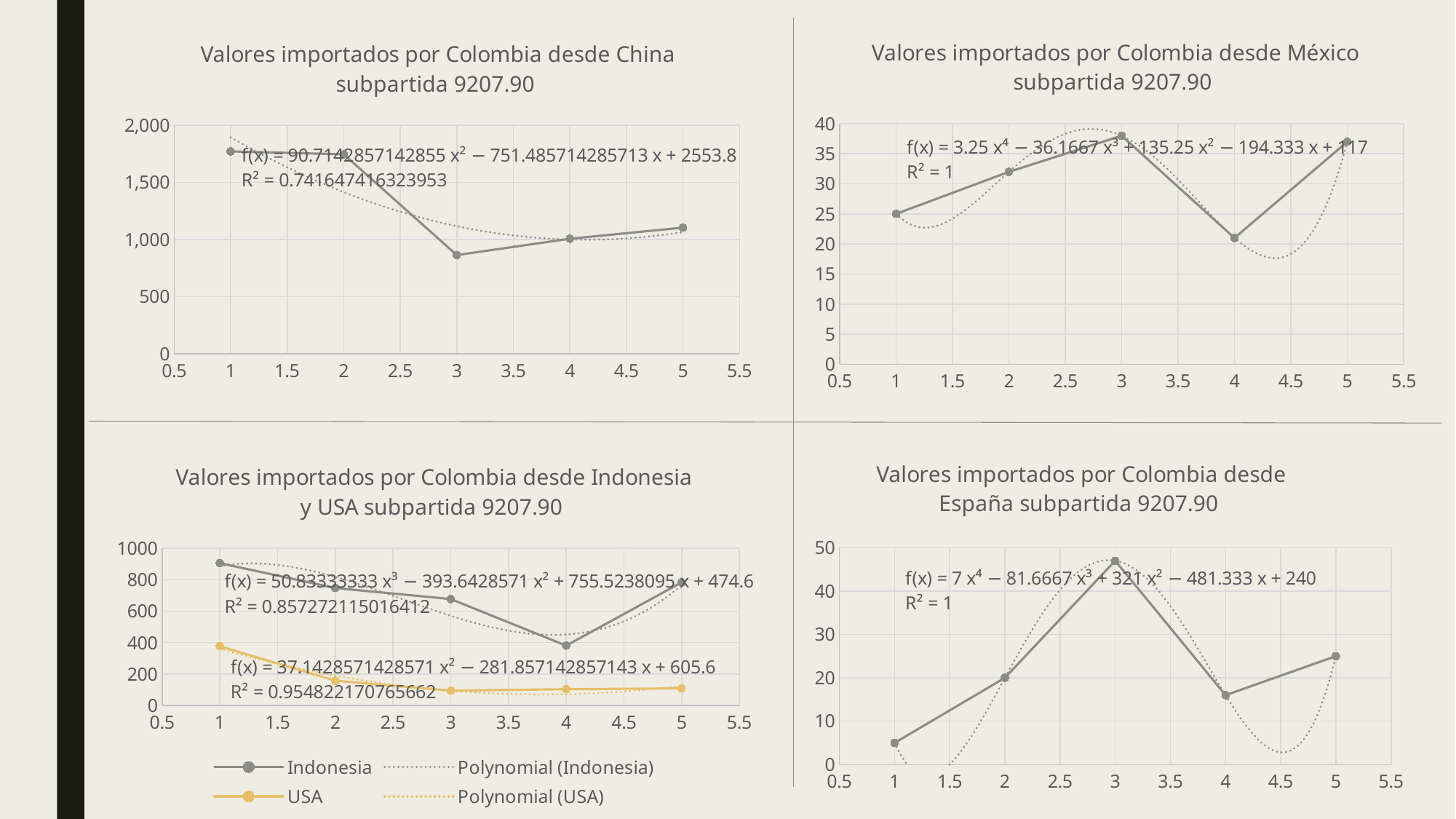
On the chart 'Valores importados por Colombia desde China subpartida 9207.90', what kind of chart is it? line chart On the chart 'Valores importados por Colombia desde China subpartida 9207.90', how many data points are plotted on the solid line? 5 On the chart 'Valores importados por Colombia desde Indonesia y USA subpartida 9207.90', how many entries does the legend list? 4 On the chart 'Valores importados por Colombia desde China subpartida 9207.90', at which x value is the plotted value highest? 1 On the chart 'Valores importados por Colombia desde Indonesia y USA subpartida 9207.90', which series has the larger value at x = 1, Indonesia or USA? Indonesia On the chart 'Valores importados por Colombia desde México subpartida 9207.90', is the value at x = 4 greater or less than 25? less On the chart 'Valores importados por Colombia desde México subpartida 9207.90', what R² value is shown for the trendline? 1 On the chart 'Valores importados por Colombia desde China subpartida 9207.90', is the value at x = 3 greater or less than 1,000? less On the chart 'Valores importados por Colombia desde Indonesia y USA subpartida 9207.90', is the Indonesia value at x = 1 greater or less than 800? greater On the chart 'Valores importados por Colombia desde México subpartida 9207.90', at which x value is the plotted value lowest? 4 On the chart 'Valores importados por Colombia desde España subpartida 9207.90', at which x value is the plotted value highest? 3 On the chart 'Valores importados por Colombia desde China subpartida 9207.90', at which x value is the plotted value lowest? 3